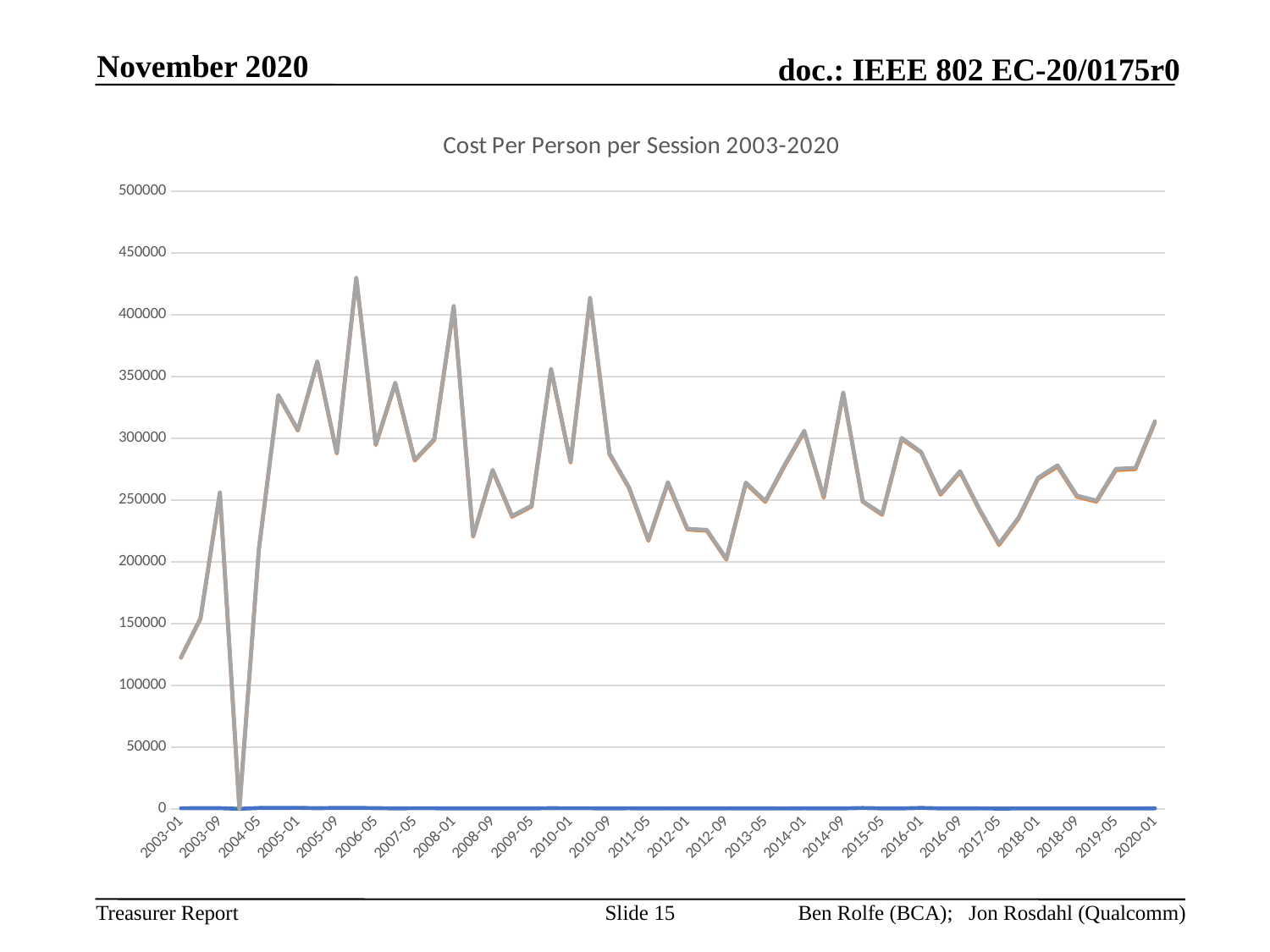
Is the value for 2020-01 greater or less than 300000? greater Which has the larger value, 2003-01 or 2020-01? 2020-01 What kind of chart is shown on the slide? line chart Is the value for 2004-05 greater or less than 50000? greater Is the value for 2014-09 greater or less than 300000? greater Does the line generally rise or fall from 2017-05 to 2020-01? rise What is the title of the chart? Cost Per Person per Session 2003-2020 What is the highest value shown on the y axis? 500000